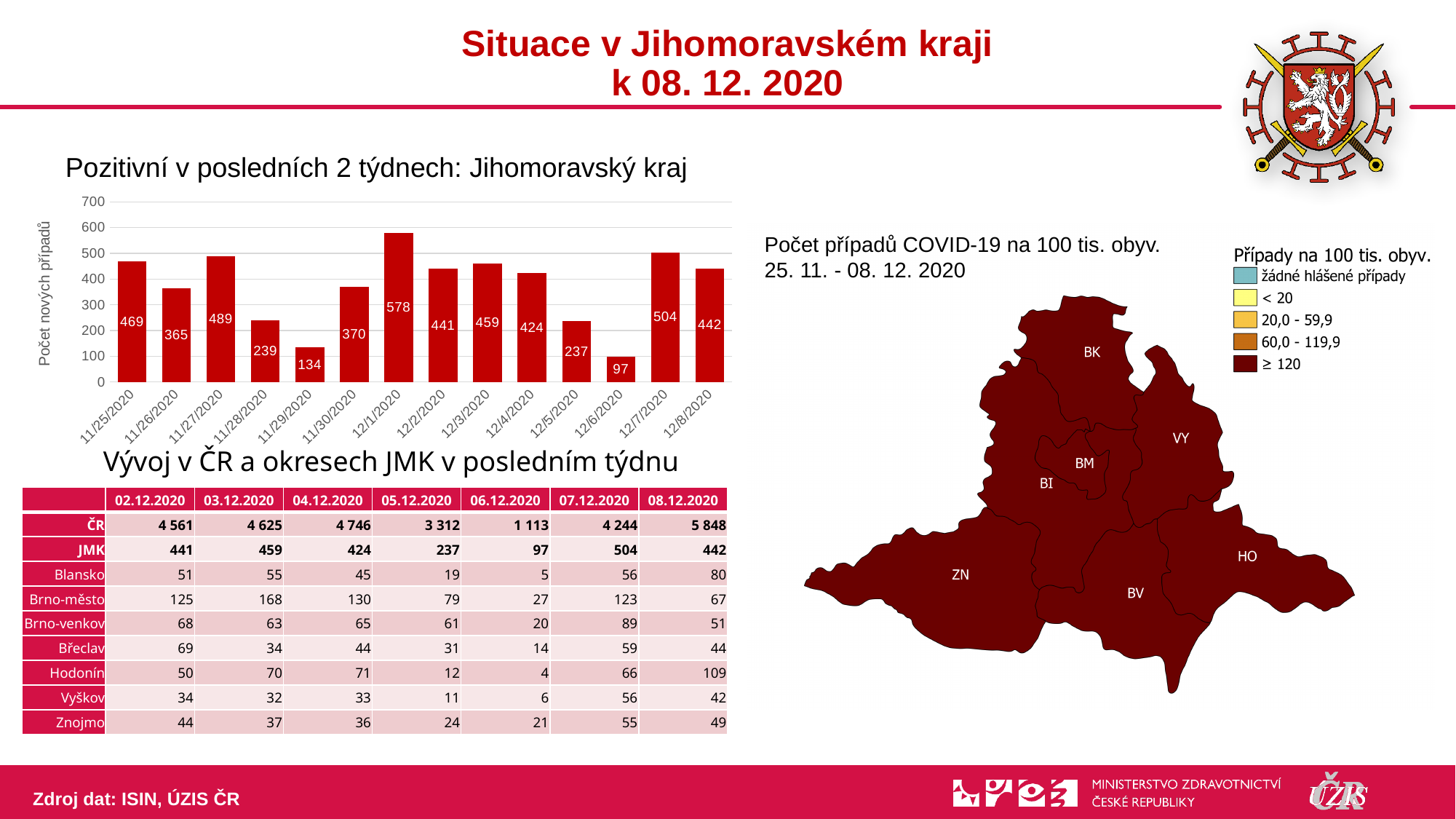
What is the label of the vertical axis of the bar chart? Počet nových případů Is the value for 12/5/2020 in the bar chart greater or less than 300? less How many dates (bars) are shown in the bar chart? 14 In the bar chart, what is the value for 12/7/2020? 504 Which date has the lowest value in the bar chart? 12/6/2020 In the bar chart, what is the difference between the values for 11/27/2020 and 11/28/2020? 250 In the bar chart, what is the value for 12/1/2020? 578 In the bar chart, which is larger: the value for 11/25/2020 or the value for 11/26/2020? 11/25/2020 In the bar chart, what is the value for 11/29/2020? 134 Which date has the highest value in the bar chart? 12/1/2020 What kind of chart is used to show the positive cases in the last 2 weeks? bar chart In the bar chart, what is the difference between the values for 12/1/2020 and 12/6/2020? 481